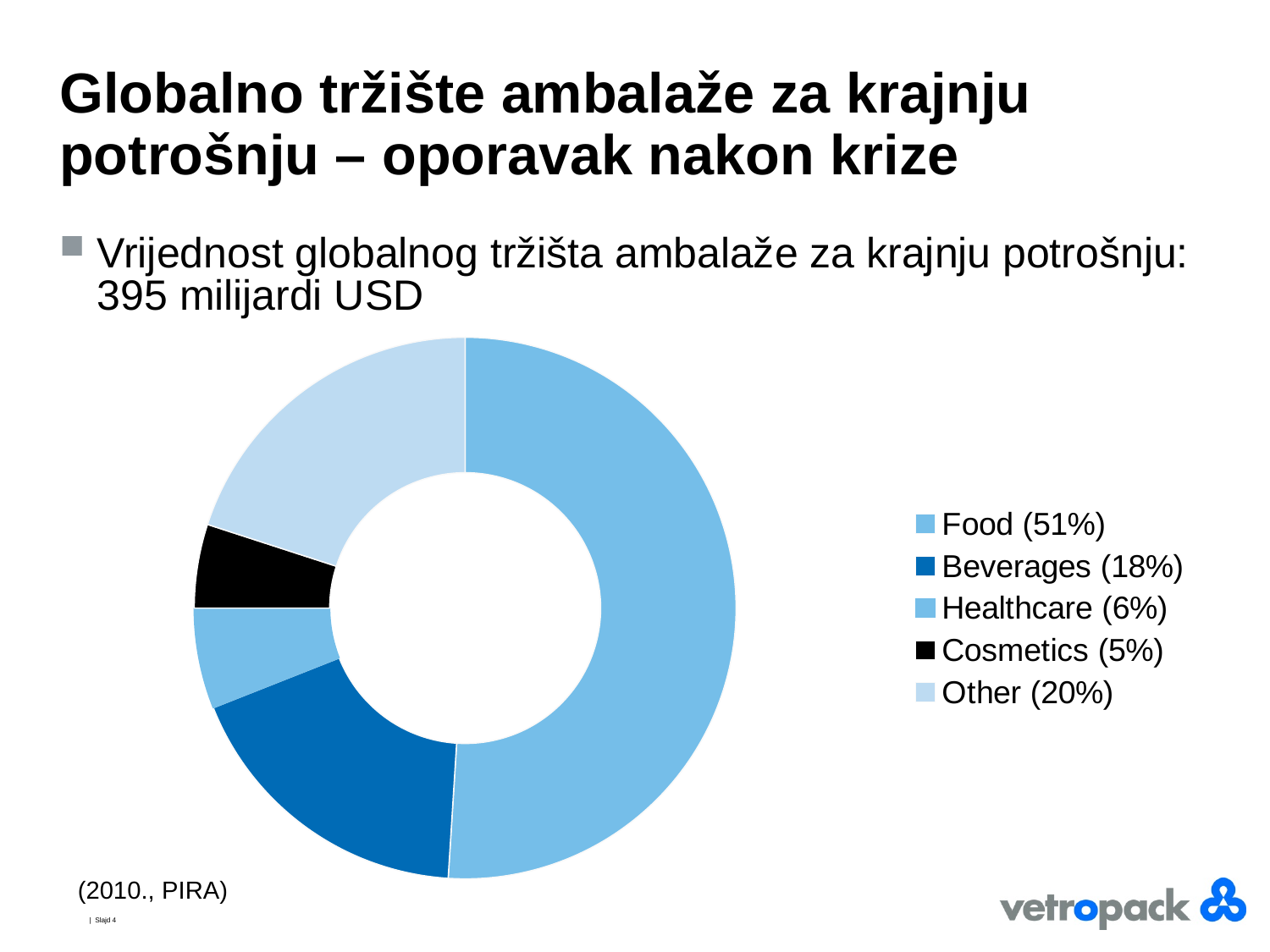
What share of the market does Cosmetics account for? 5% What share of the global consumer packaging market does Food account for? 51% How many categories are shown in the chart? 5 What share of the market does Healthcare account for? 6% Which category is shown in black in the chart? Cosmetics Which category has the smallest share of the market? Cosmetics What is the difference in percentage points between the Food share and the Beverages share? 33 What share of the market does Other account for? 20% What share of the market does Beverages account for? 18% Which category has the largest share of the market? Food Which has a larger share, Beverages or Other? Other What kind of chart is shown on the slide? Doughnut (pie) chart